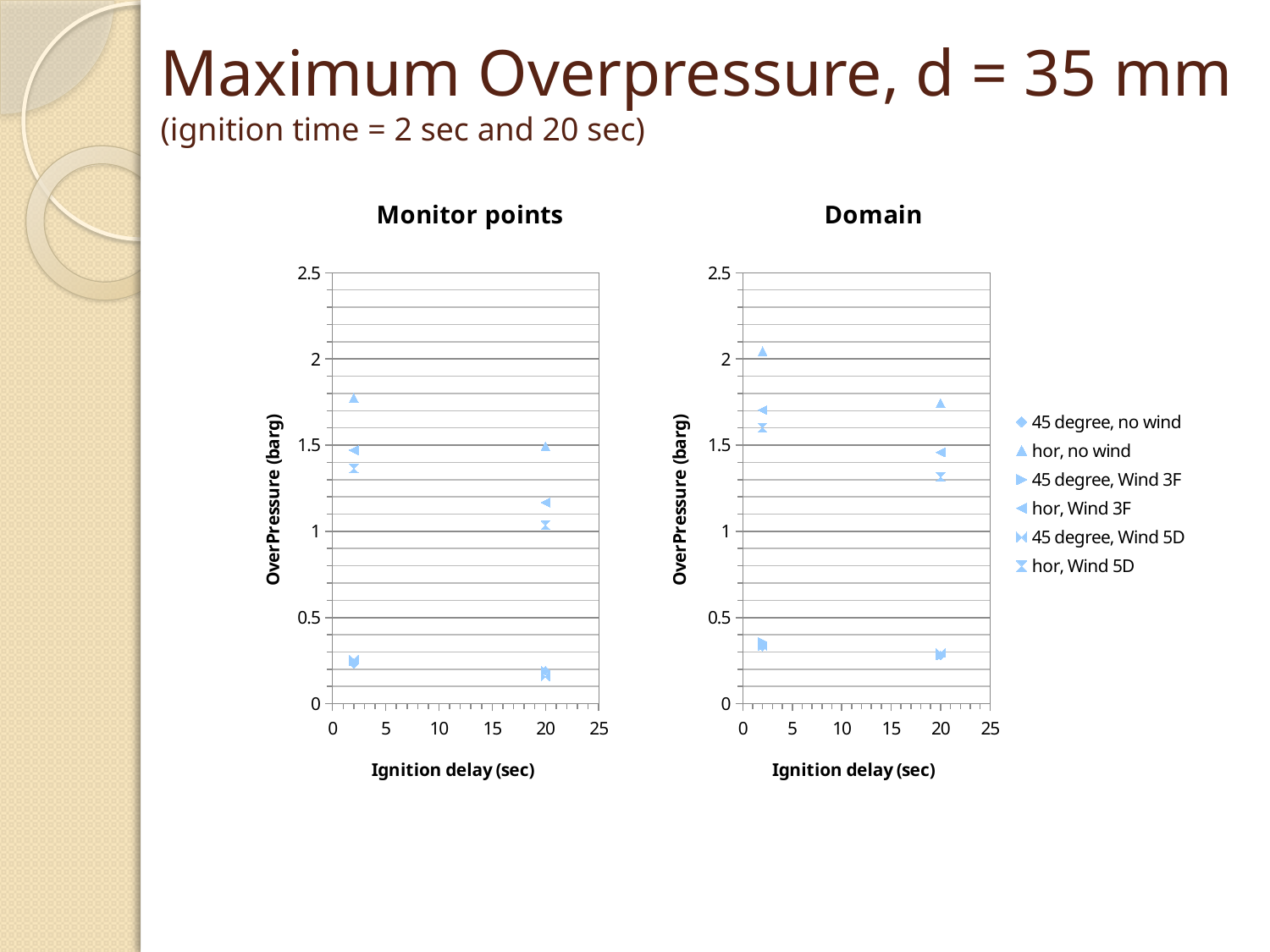
In the "Monitor points" chart, does the value for "hor, no wind" rise or fall from an ignition delay of 2 sec to 20 sec? fall What is the x-axis label of the "Monitor points" chart? Ignition delay (sec) How many series does the legend list? 6 In the "Monitor points" chart, is the value for "hor, no wind" at an ignition delay of 2 sec greater or less than 1.5? greater In the "Domain" chart, is the value for "hor, Wind 5D" at an ignition delay of 20 sec greater or less than 1.5? less In the "Domain" chart, is the value for "hor, no wind" at an ignition delay of 20 sec greater or less than 1.5? greater What is the y-axis label of the "Domain" chart? OverPressure (barg) What kind of chart is the "Monitor points" chart? scatter chart In the "Domain" chart, which is larger for "hor, no wind": the value at 2 sec or at 20 sec ignition delay? 2 sec